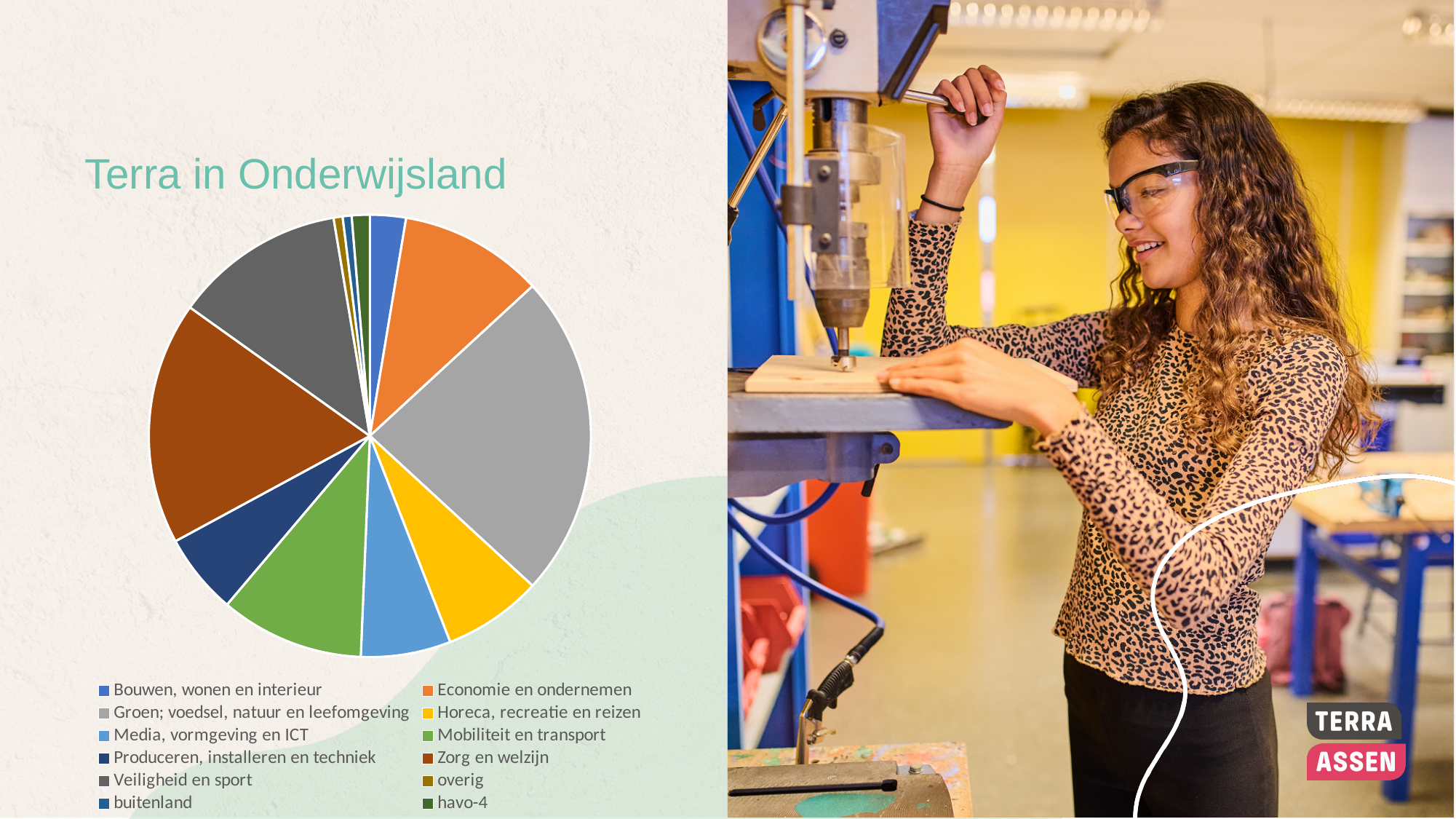
What is the title of the chart? Terra in Onderwijsland Which slice is larger: Zorg en welzijn or Horeca, recreatie en reizen? Zorg en welzijn What kind of chart is shown on the slide? pie chart What colour is the slice for Horeca, recreatie en reizen in the pie chart? yellow Which slice is larger: Veiligheid en sport or Bouwen, wonen en interieur? Veiligheid en sport Which slice is larger: Zorg en welzijn or Mobiliteit en transport? Zorg en welzijn How many categories does the legend of the pie chart list? 12 Which category has the largest slice of the pie chart? Groen; voedsel, natuur en leefomgeving